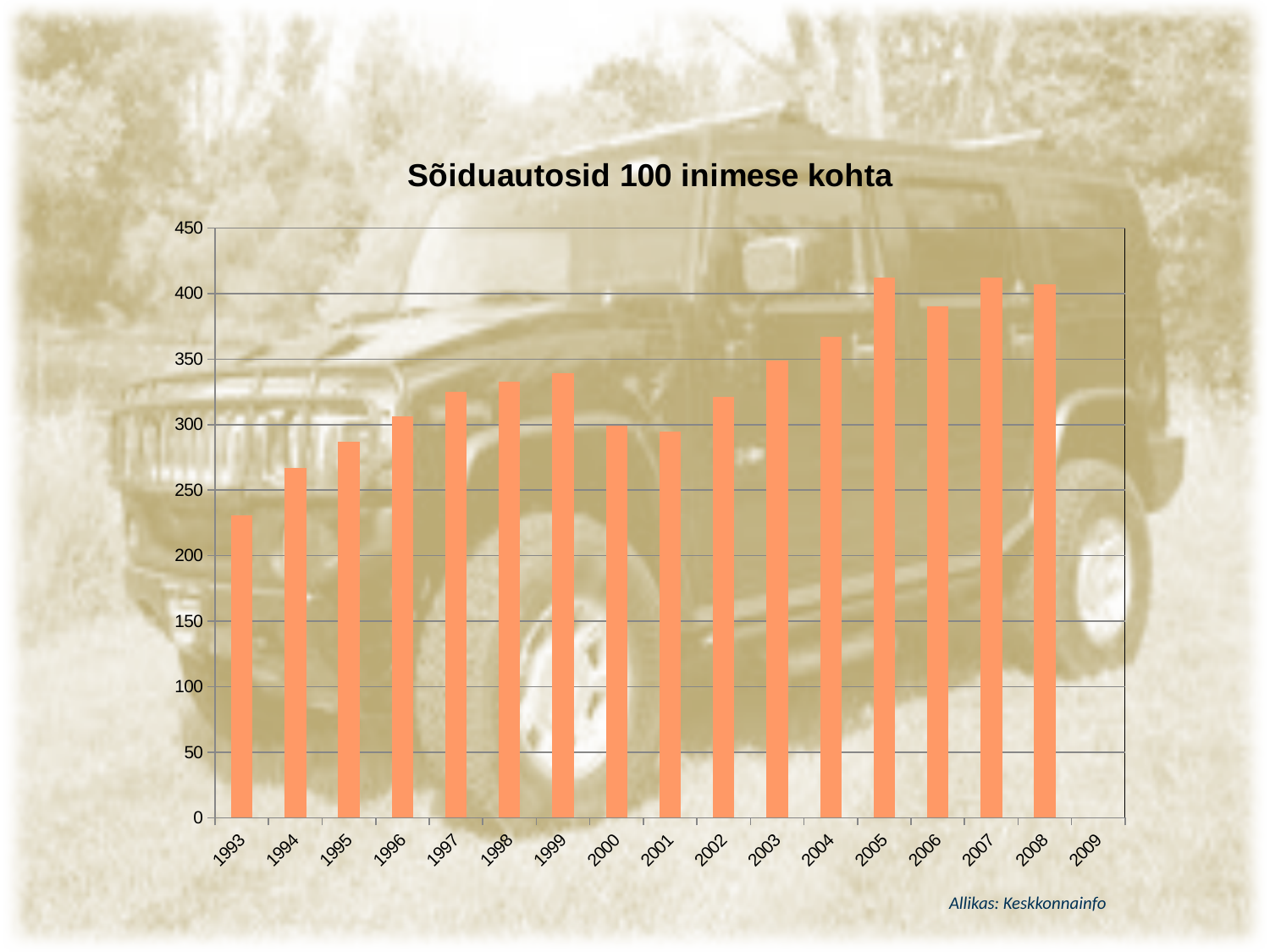
Is the value for 1999 greater or less than 350? less What is the title of the chart? Sõiduautosid 100 inimese kohta Which year has the lowest value in the chart? 1993 Is the value for 1993 greater or less than 250? less What source is cited below the chart? Keskkonnainfo What kind of chart is shown on the slide? bar chart Do the values rise or fall from 1993 to 1999? rise Which year has the larger value, 1999 or 2000? 1999 Is the value for 2006 greater or less than 400? less Which year has the larger value, 2005 or 2006? 2005